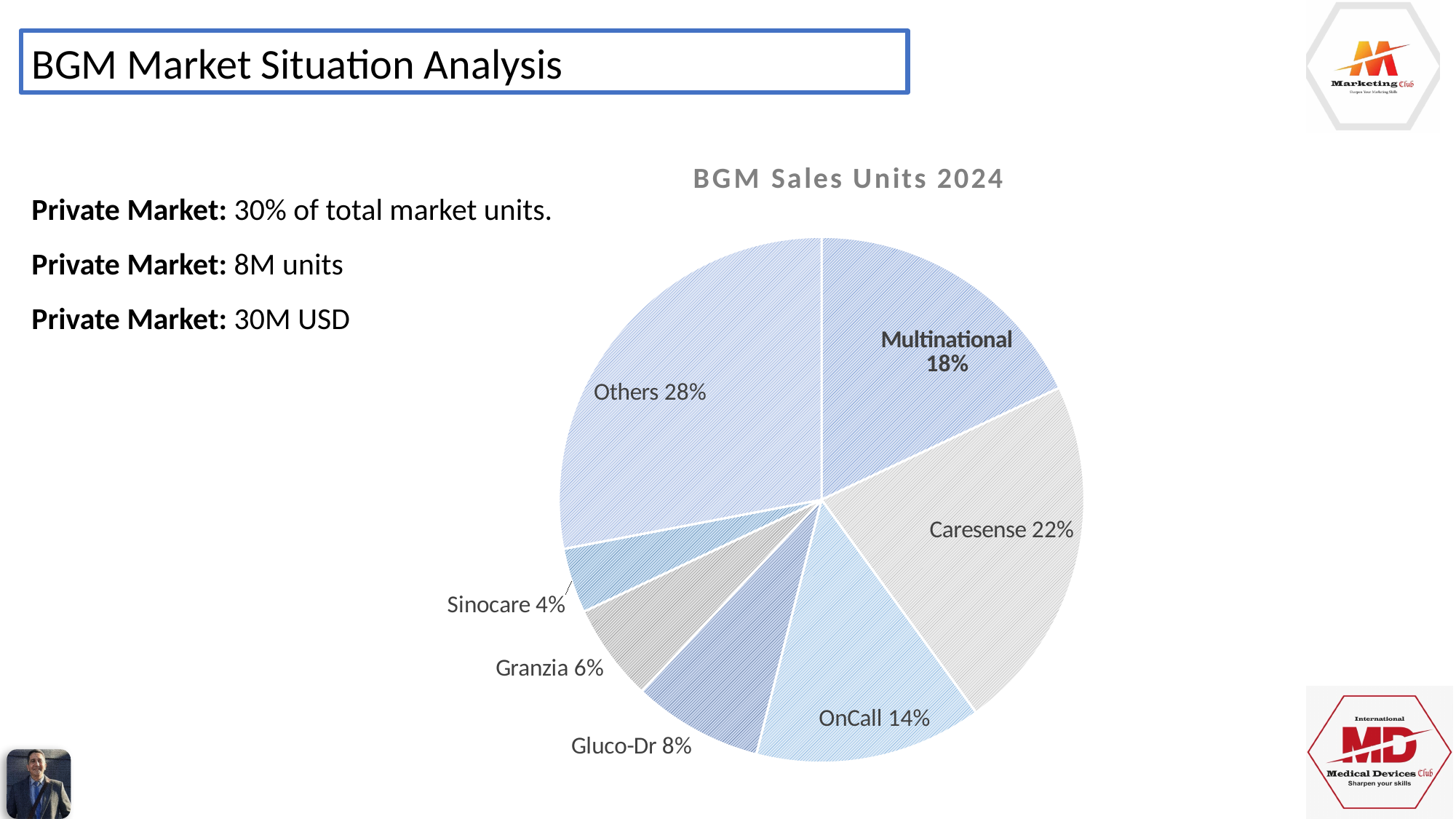
What type of chart is shown on the slide? Pie chart Which has a larger share, Gluco-Dr or Granzia? Gluco-Dr Which slice of the pie chart is the largest? Others Which slice of the pie chart is the smallest? Sinocare What share of BGM sales units does OnCall hold? 14% What share of BGM sales units does Sinocare hold? 4% What is the combined share of Multinational and Caresense? 40% What is the difference in share between Caresense and Multinational? 4% How many slices does the pie chart have? 7 What share of BGM sales units does Granzia hold? 6% What share of BGM sales units does Caresense hold? 22% What is the title of the chart? BGM Sales Units 2024